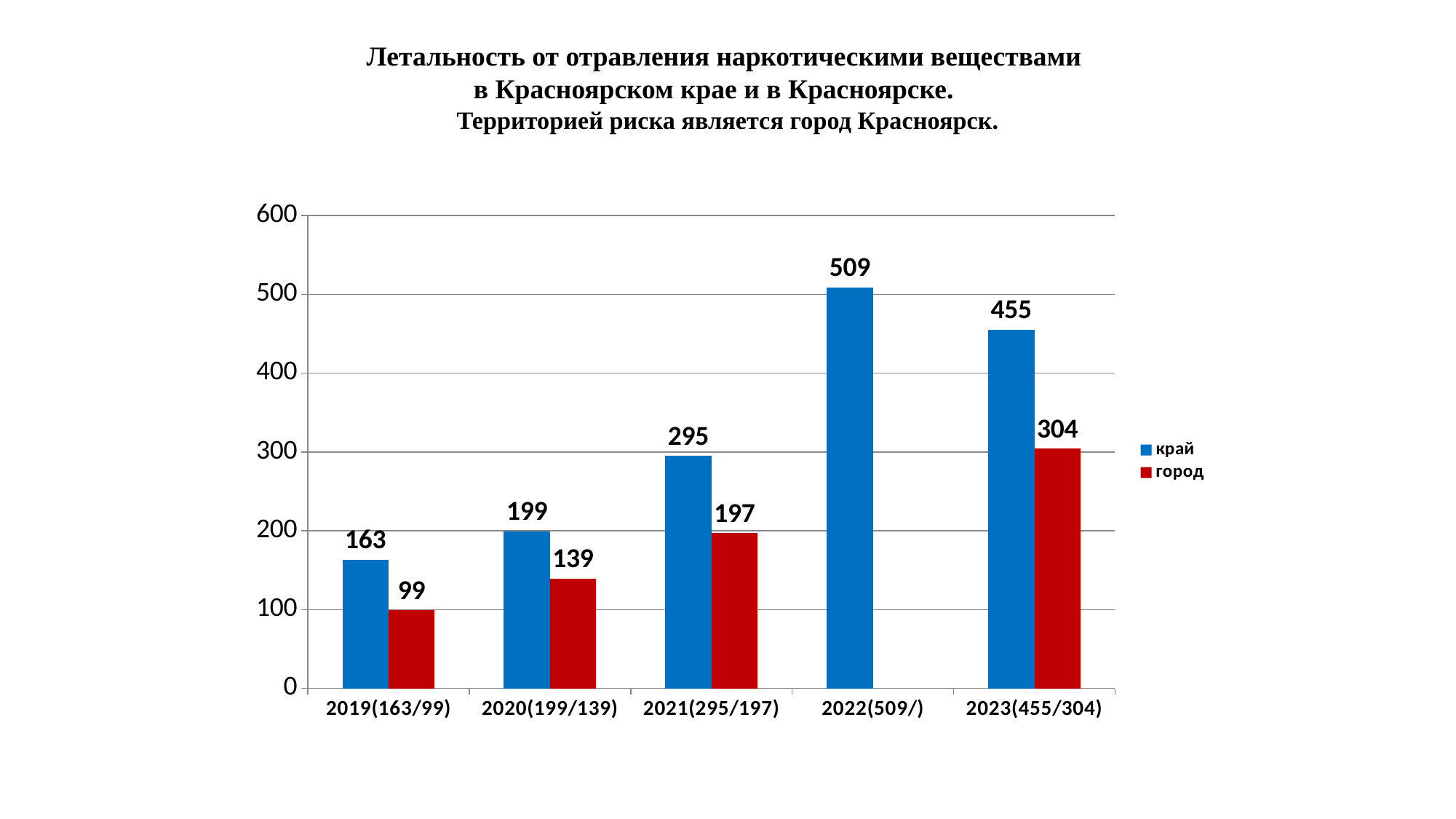
Which category has the highest value for край? 2022(509/) How many series does the legend list? 2 Which is larger: the город value in 2023(455/304) or the край value in 2021(295/197)? город in 2023(455/304) What is the difference between the край values for 2022(509/) and 2023(455/304)? 54 How many categories are shown on the x axis? 5 What is the value for город in 2020(199/139)? 139 What kind of chart is shown on the slide? bar chart What is the value for город in 2023(455/304)? 304 Which colour represents the город series? red What is the difference between the край and город values in 2021(295/197)? 98 What is the value for край in 2022(509/)? 509 Which category has the lowest value for город? 2019(163/99)